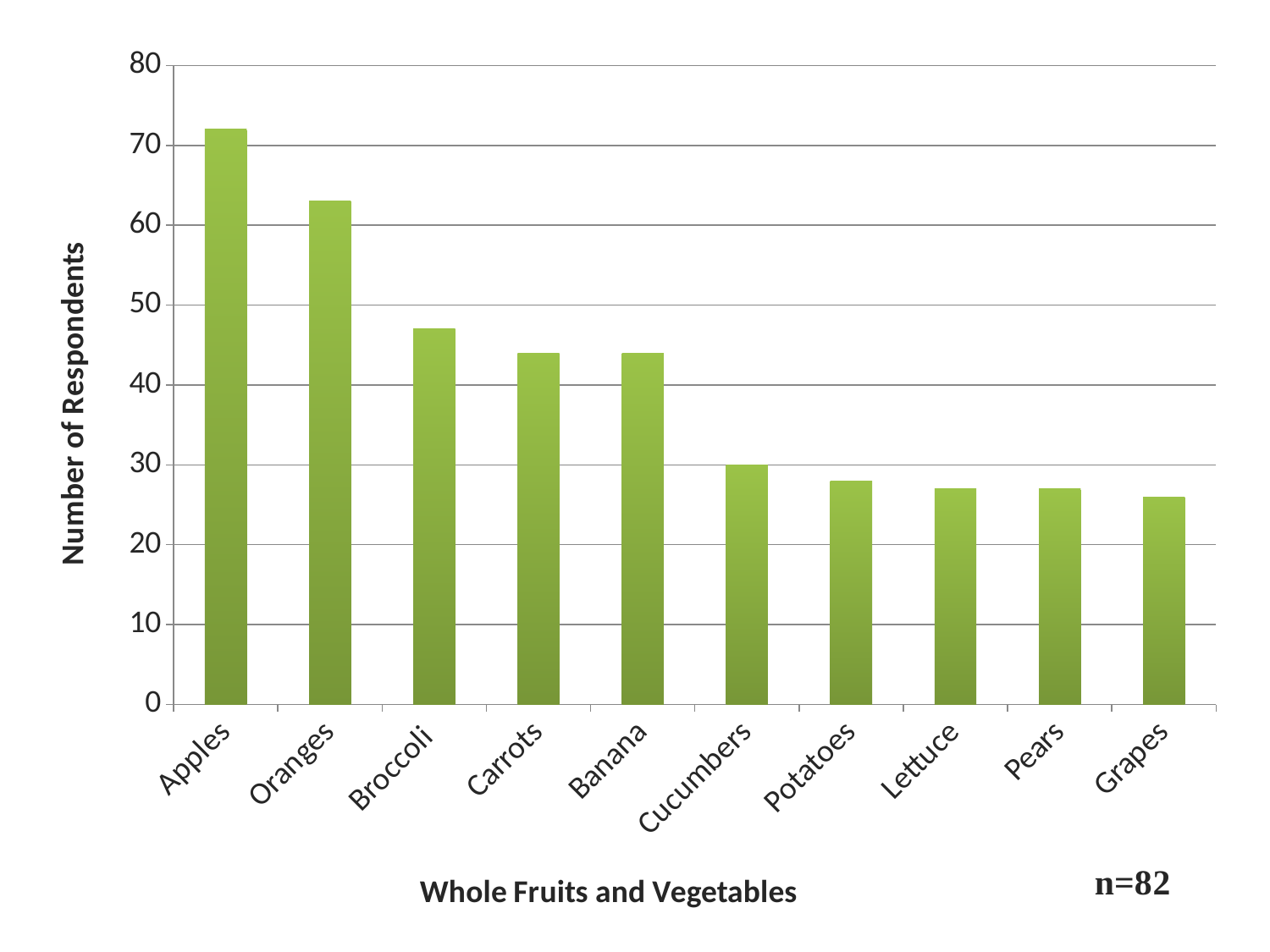
Is the value for Grapes greater or less than 30? less Which category has the highest number of respondents? Apples Do the values generally rise or fall moving from left to right along the x axis? fall How many fruit and vegetable categories are plotted on the chart? 10 What is the title of the vertical axis? Number of Respondents Which has more respondents, Apples or Oranges? Apples What kind of chart is shown on the slide? bar chart Is the value for Apples greater or less than 70? greater Is the value for Broccoli greater or less than 50? less Which has more respondents, Broccoli or Cucumbers? Broccoli What is the number of respondents for Cucumbers? 30